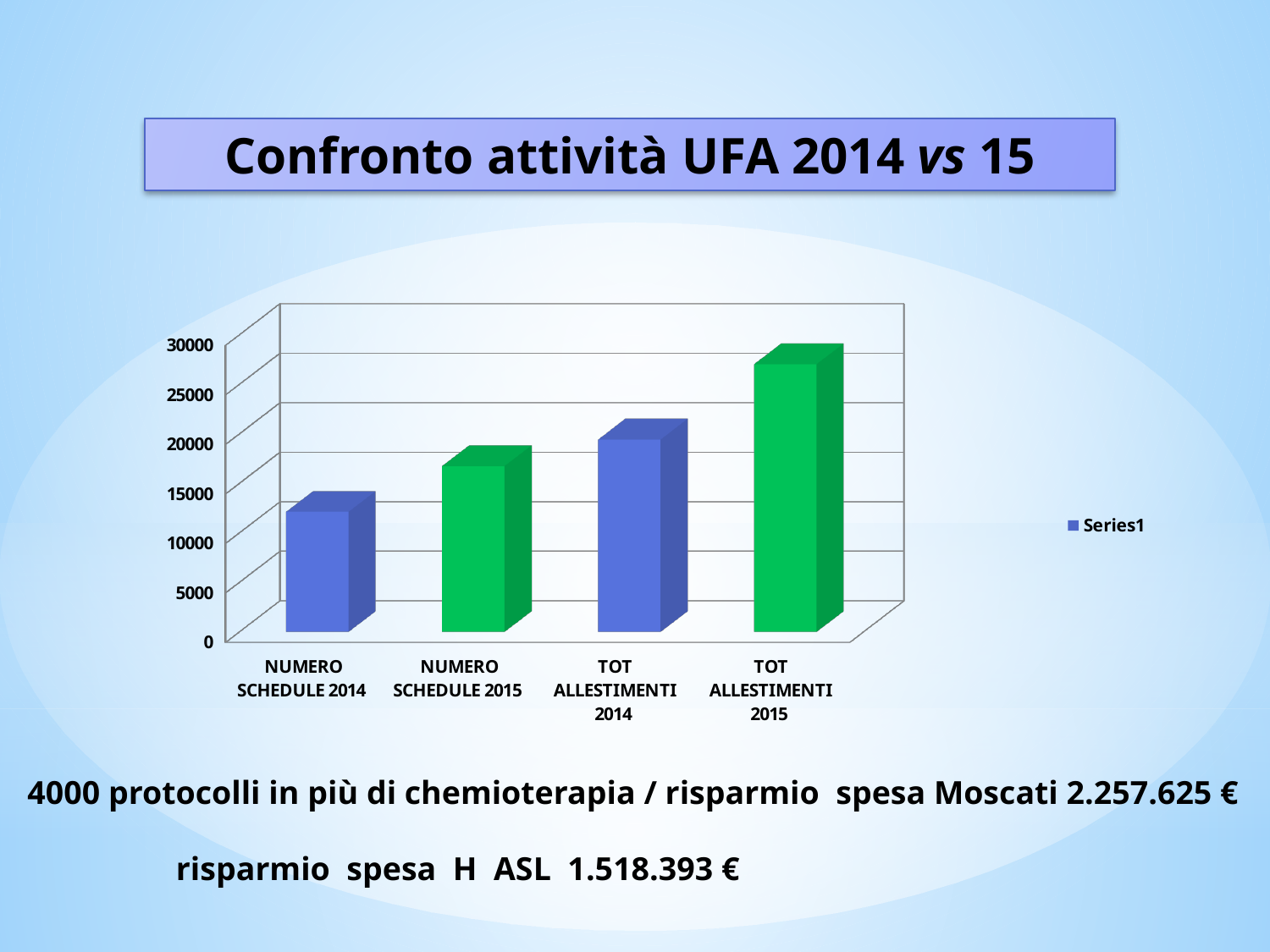
Which is larger, the value for TOT ALLESTIMENTI 2014 or the value for NUMERO SCHEDULE 2015? TOT ALLESTIMENTI 2014 How many series does the chart legend list? 1 Which is larger, the value for NUMERO SCHEDULE 2015 or the value for NUMERO SCHEDULE 2014? NUMERO SCHEDULE 2015 Is the value for NUMERO SCHEDULE 2014 greater or less than 10000? greater Do the bar values rise or fall from left to right across the categories? rise Which category has the highest bar in the chart? TOT ALLESTIMENTI 2015 How many categories are plotted in the chart? 4 Is the value for TOT ALLESTIMENTI 2015 greater or less than 25000? greater What kind of chart is shown on the slide? bar chart Which category has the lowest bar in the chart? NUMERO SCHEDULE 2014 Is the value for TOT ALLESTIMENTI 2014 greater or less than 25000? less